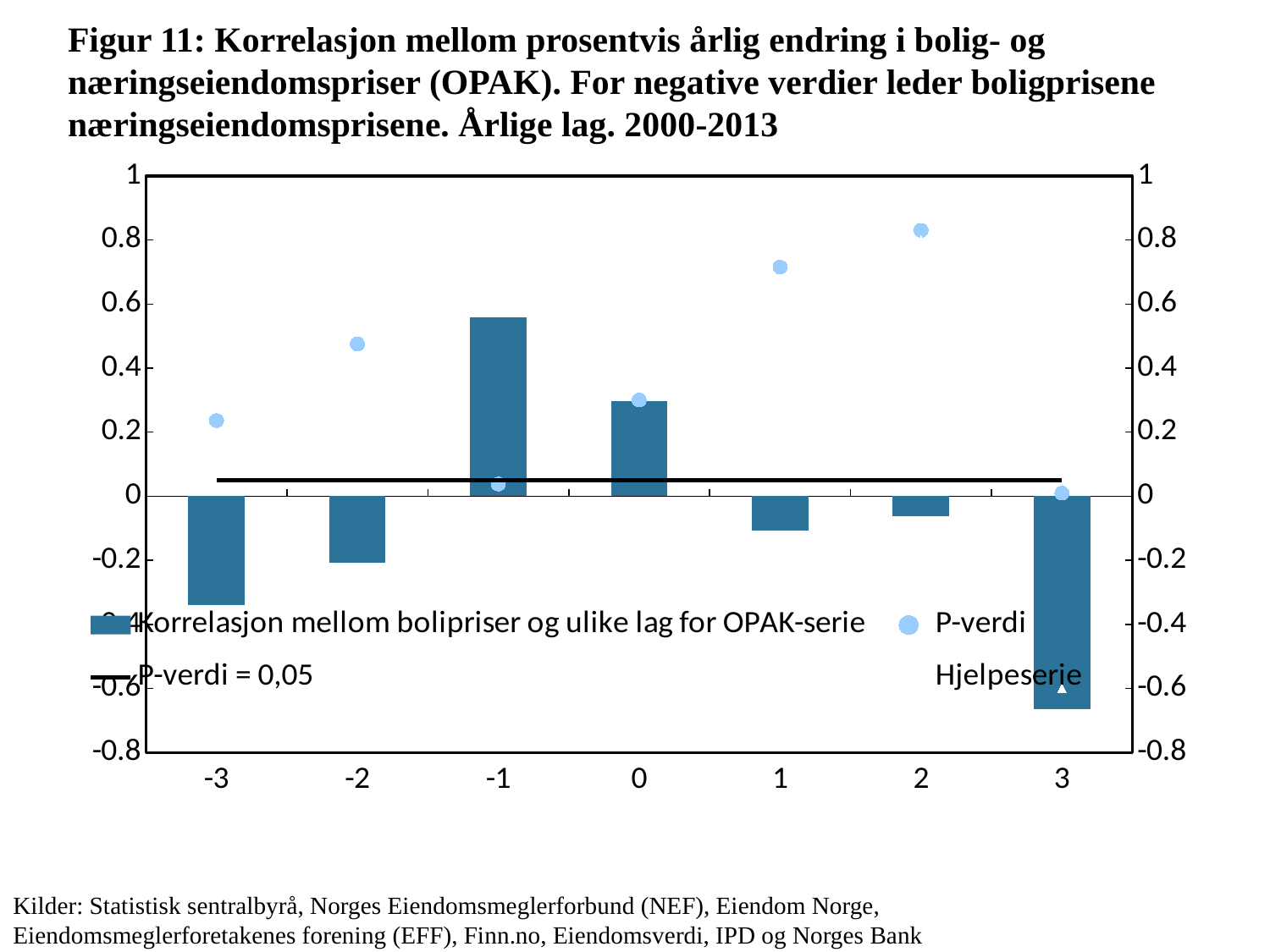
How many series does the legend list? 4 How many lag values are shown on the x axis? 7 Is the correlation bar at lag 3 greater or less than -0.6? less At which lag is the correlation bar lowest? 3 At which lag is the correlation bar highest? -1 Is the correlation bar at lag -1 greater or less than 0.4? greater What kind of chart is used to show the series 'Korrelasjon mellom bolipriser og ulike lag for OPAK-serie'? bar chart What value does the horizontal black line represent according to the legend? P-verdi = 0,05 At which lag is the P-verdi point highest? 2 Is the P-verdi point at lag 1 greater or less than 0.6? greater Which correlation bar is larger, the one at lag -3 or the one at lag -2? -2